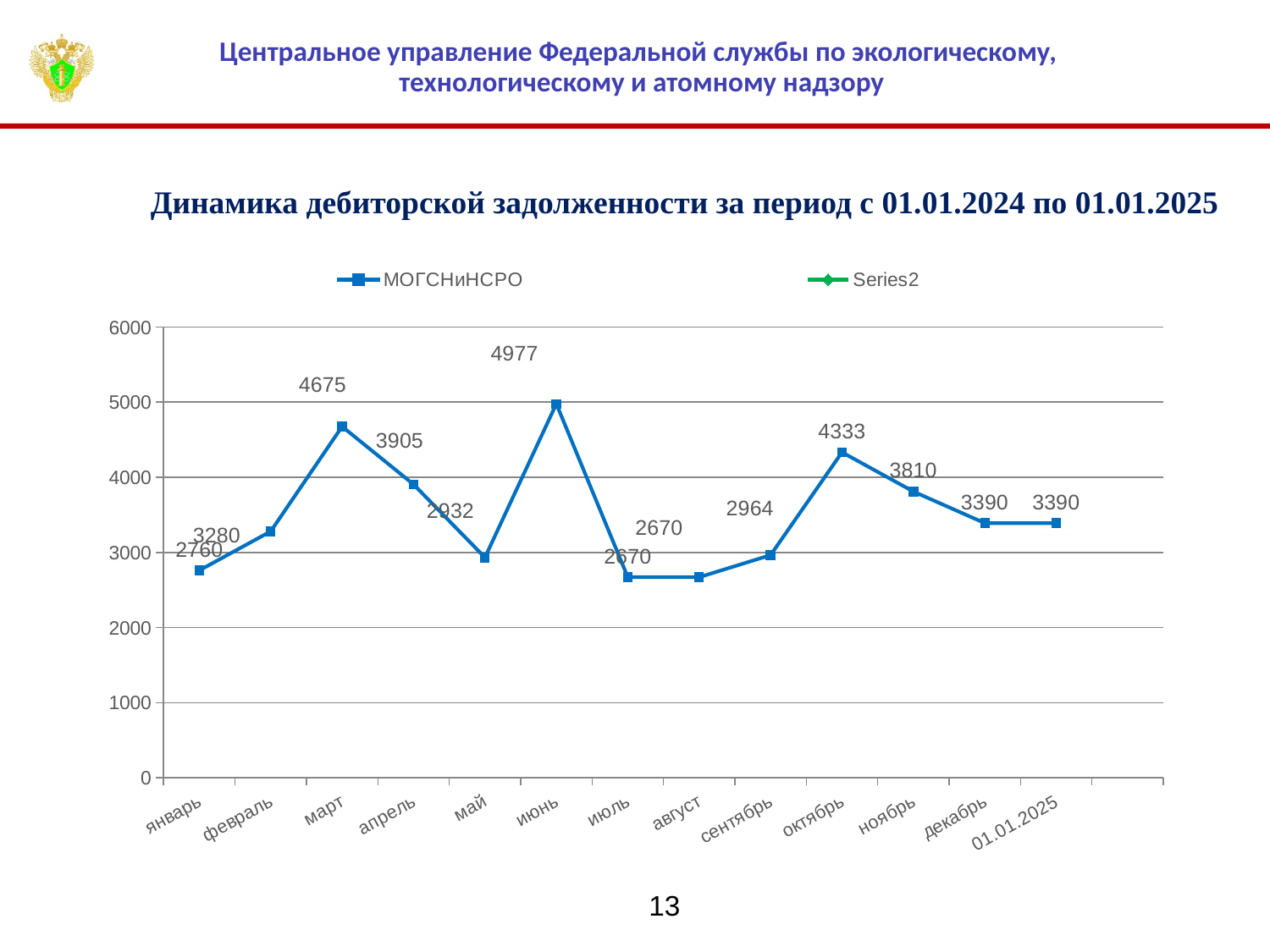
Does the value rise or fall from сентябрь to октябрь? rise How many series does the legend list? 2 Which month has the highest value? июнь Which is larger, the value for ноябрь or the value for декабрь? ноябрь Is the value for май greater or less than 3000? less How many data points are plotted on the line? 13 What is the title of the chart? Динамика дебиторской задолженности за период с 01.01.2024 по 01.01.2025 What is the value for октябрь? 4333 What is the value for июнь? 4977 What is the value for январь? 2760 What is the difference between the values for март and апрель? 770 What kind of chart is shown? line chart